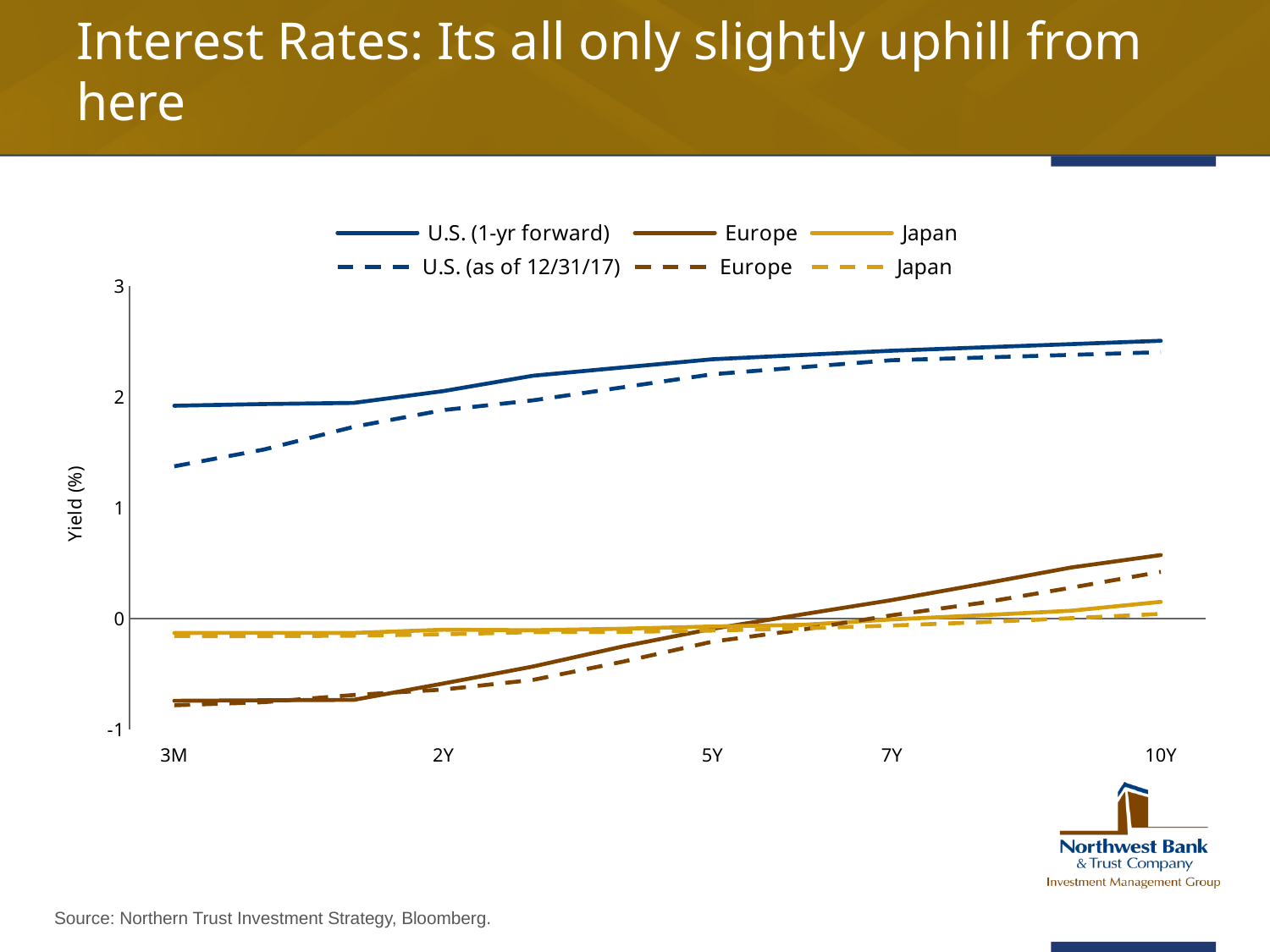
Which series has the highest value at 10Y? U.S. (1-yr forward) Does the U.S. (1-yr forward) line rise or fall from 3M to 10Y? rise Is the value for the solid Europe line at 10Y greater or less than 0? greater Is the value for U.S. (1-yr forward) at 10Y greater or less than 2? greater How many maturity labels are shown on the x axis? 5 At 3M, which is higher: U.S. (1-yr forward) or U.S. (as of 12/31/17)? U.S. (1-yr forward) Is the value for the solid Europe line at 3M greater or less than 0? less What is the label of the y axis? Yield (%) What kind of chart is shown on the slide? line chart How many series does the legend list? 6